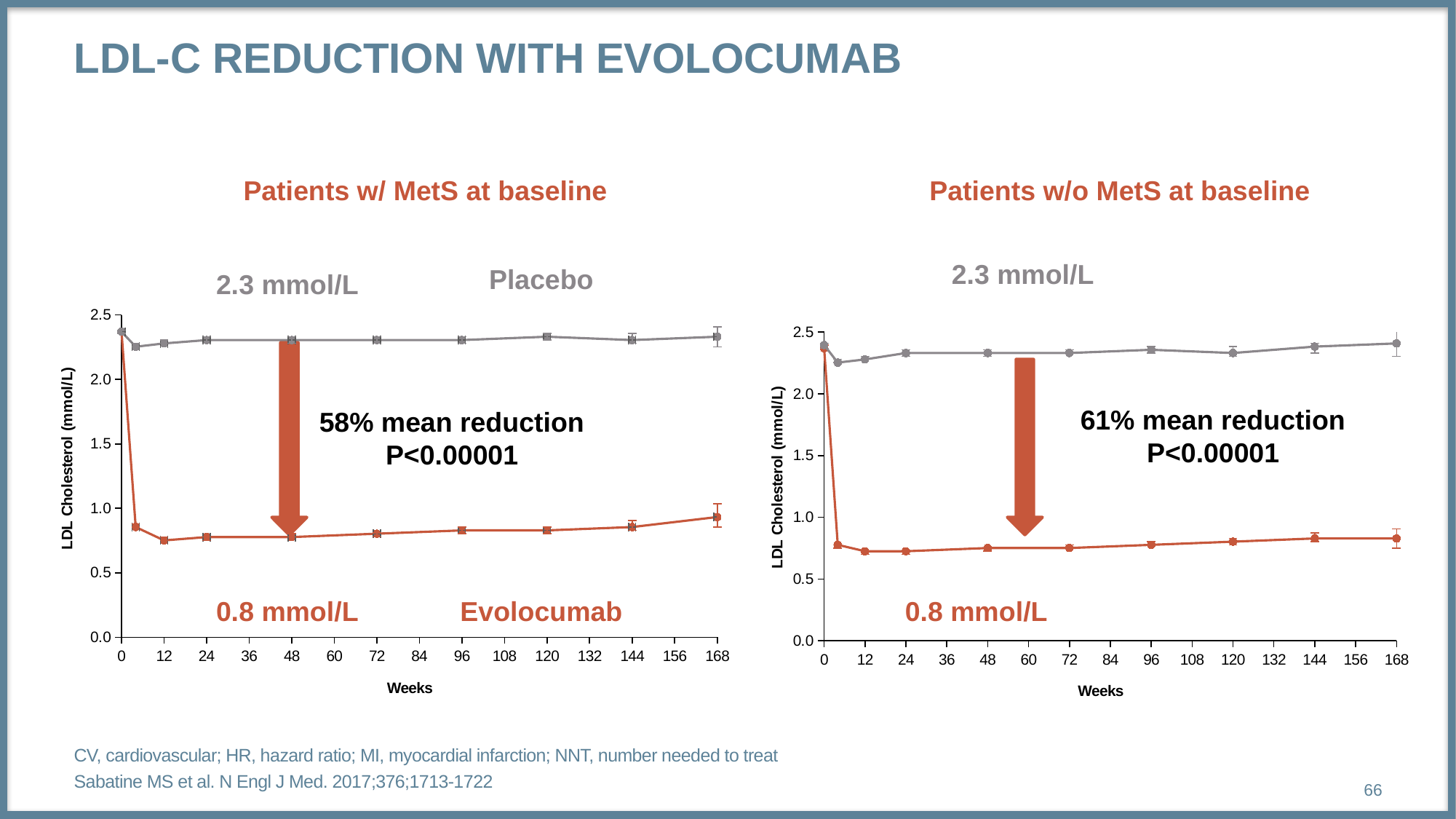
What kind of chart is used for 'Patients w/ MetS at baseline'? Line chart How many series are labelled in the 'Patients w/ MetS at baseline' chart? 2 In the 'Patients w/ MetS at baseline' chart, how does the Evolocumab line change between week 0 and week 12? It falls sharply What is the y-axis title of the 'Patients w/o MetS at baseline' chart? LDL Cholesterol (mmol/L) In the 'Patients w/ MetS at baseline' chart, what P value is shown for the mean reduction? P<0.00001 In the 'Patients w/ MetS at baseline' chart, is the Placebo value at week 48 greater or less than 2.0? greater In the 'Patients w/o MetS at baseline' chart, what LDL-C level is annotated for the lower (Evolocumab) line? 0.8 mmol/L In the 'Patients w/ MetS at baseline' chart, what LDL-C level is annotated for the Placebo line? 2.3 mmol/L In the 'Patients w/o MetS at baseline' chart, at week 168, which line is higher: the grey (placebo) line or the orange (evolocumab) line? The grey (placebo) line In the 'Patients w/ MetS at baseline' chart, is the Evolocumab value at week 48 greater or less than 1.0? less In the 'Patients w/ MetS at baseline' chart, what mean reduction in LDL-C is annotated? 58% mean reduction In the 'Patients w/o MetS at baseline' chart, what mean reduction in LDL-C is annotated? 61% mean reduction